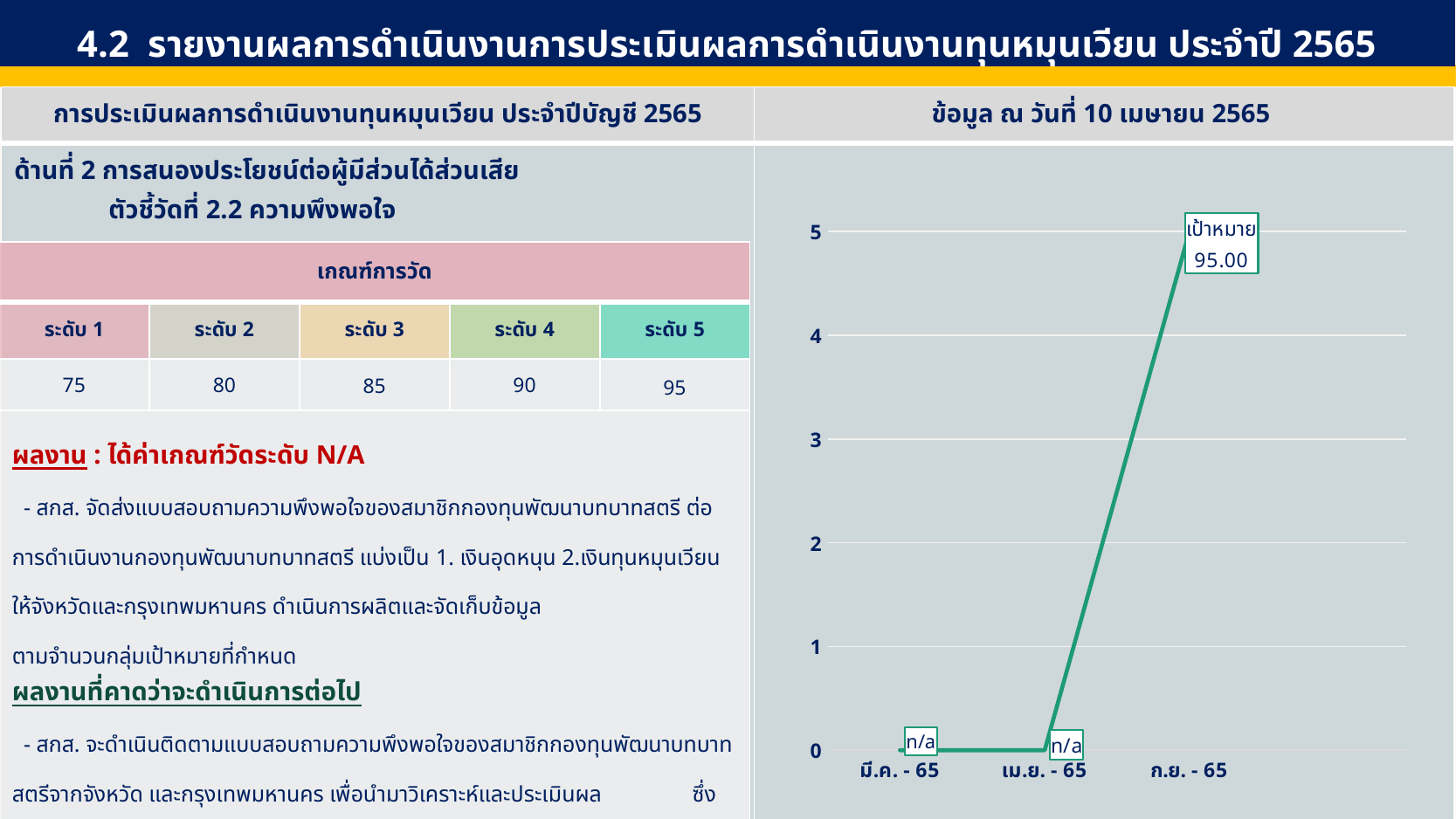
Is the plotted point for เม.ย. - 65 greater or less than 1 on the y axis? less Is the plotted point for ก.ย. - 65 greater or less than 4 on the y axis? greater What data label is shown for มี.ค. - 65 in the chart? n/a What kind of chart is shown on the right side of the slide? line chart How many points are plotted along the x axis of the chart? 3 Which is higher on the chart, the point for มี.ค. - 65 or the point for ก.ย. - 65? ก.ย. - 65 What word appears above the number in the label box at ก.ย. - 65? เป้าหมาย What numeric value is shown in the label at ก.ย. - 65 in the chart? 95.00 Does the line rise or fall from เม.ย. - 65 to ก.ย. - 65? rise Which category has the highest point on the chart? ก.ย. - 65 What data label is shown for เม.ย. - 65 in the chart? n/a What is the highest tick value shown on the y axis of the chart? 5